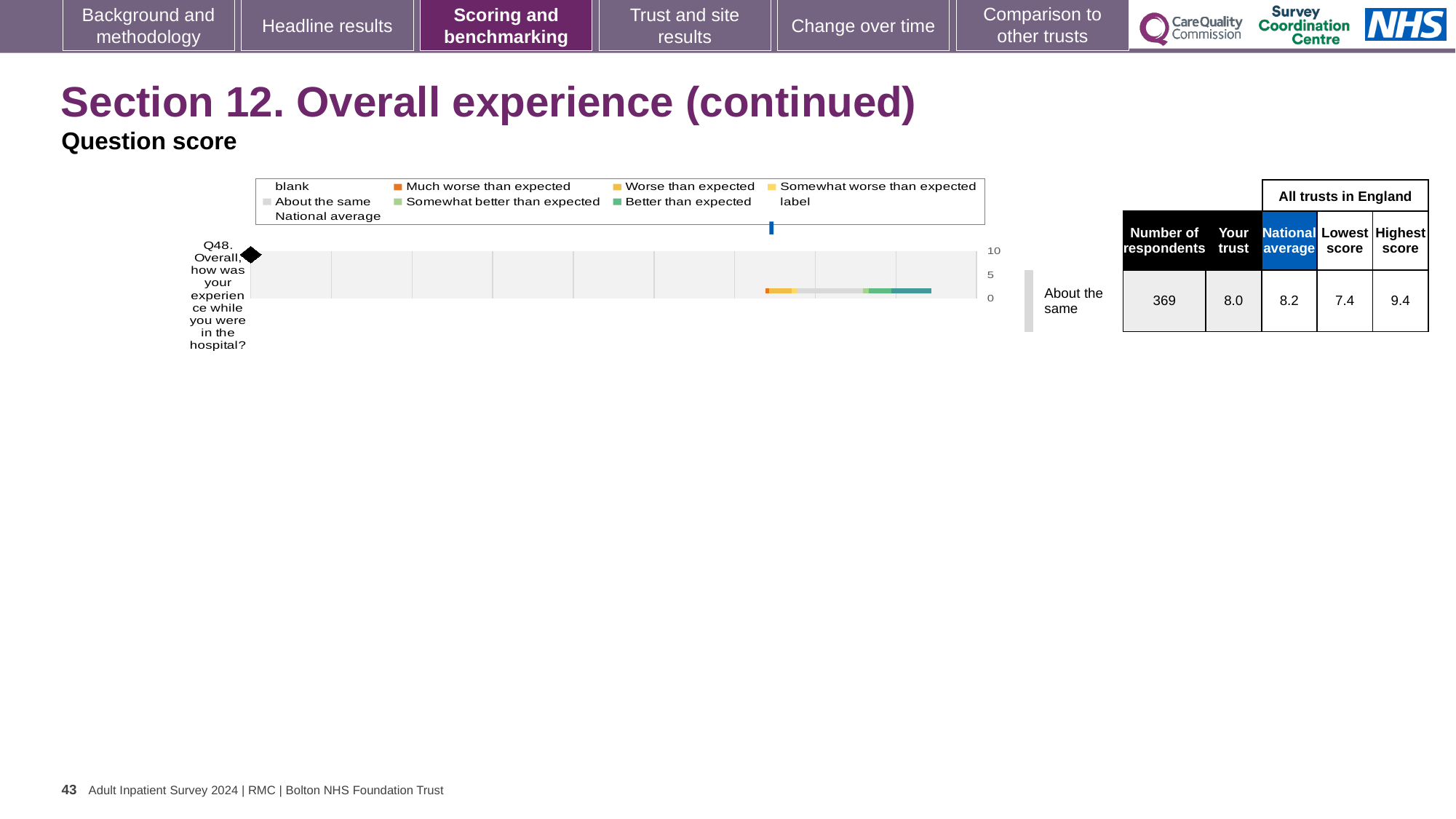
What is the national average score for Q48? 8.2 How many respondents answered Q48? 369 What is the difference between the highest score and the lowest score for Q48? 2.0 How many questions are plotted on the chart? 1 Is the 'Your trust' score for Q48 higher or lower than the national average? lower What kind of chart is used to show the Q48 question score? bar chart What is the highest score among all trusts in England for Q48? 9.4 By how much does the national average exceed the 'Your trust' score for Q48? 0.2 What is the lowest score among all trusts in England for Q48? 7.4 What benchmark category is the trust's Q48 score placed in? About the same What is the 'Your trust' score for Q48 (Overall, how was your experience while you were in the hospital?)? 8.0 What is the maximum value shown on the chart's score axis? 10